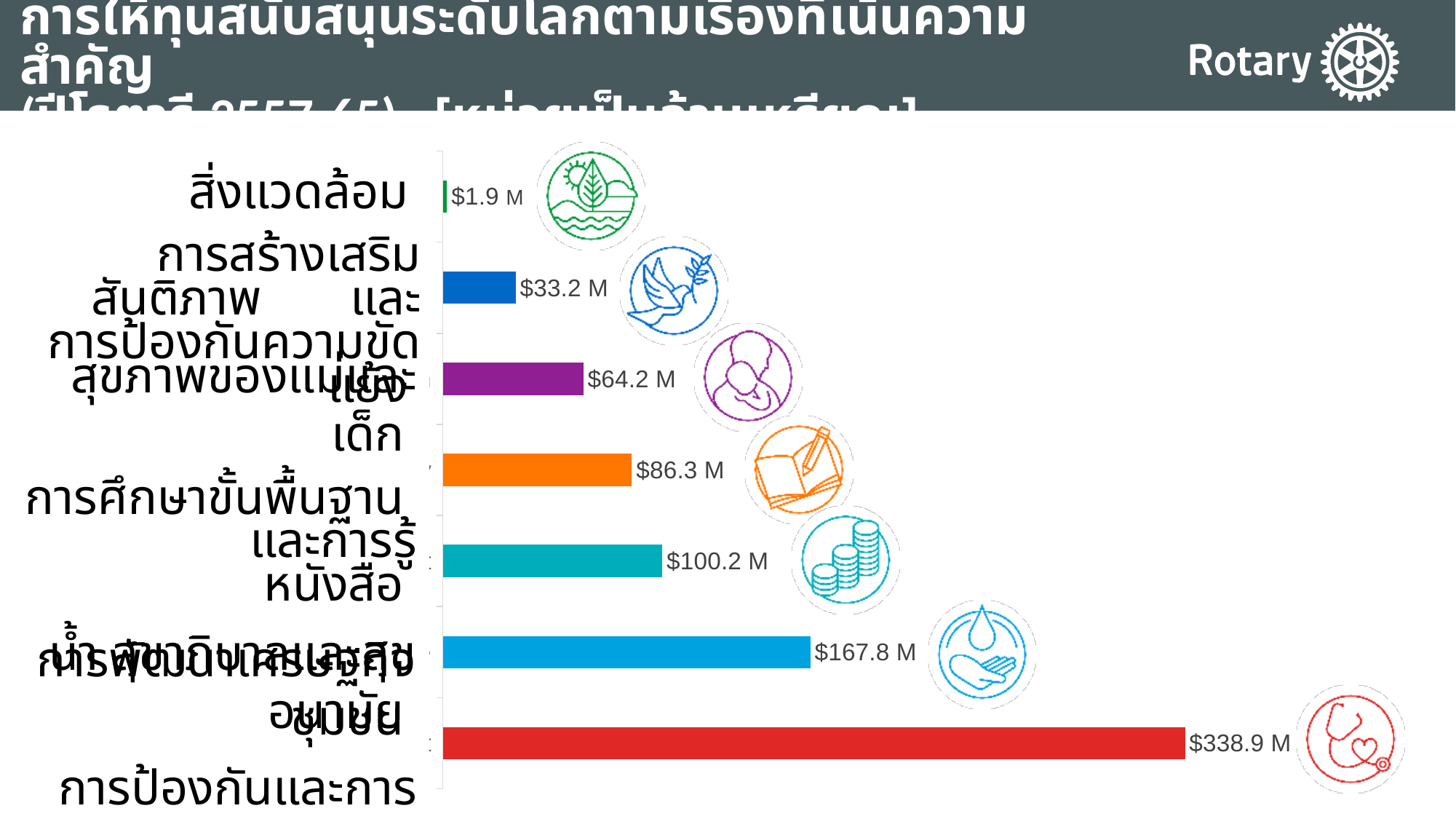
Which category has the lowest value in the chart? สิ่งแวดล้อม What is the value shown on the light blue bar with the water drop icon? $167.8 M What is the value shown on the orange bar (การศึกษาขั้นพื้นฐานและการรู้หนังสือ)? $86.3 M What is the difference between the teal bar ($100.2 M) and the orange bar ($86.3 M)? $13.9 M What is the value of the largest bar in the chart? $338.9 M What kind of chart is shown on the slide? bar chart What is the difference between the red bar ($338.9 M) and the light blue bar ($167.8 M)? $171.1 M What is the value shown on the purple bar (สุขภาพของแม่และเด็ก)? $64.2 M Which is larger: the dark blue bar with the dove icon or the purple bar with the mother-and-child icon? the purple bar ($64.2 M) What is the value shown for สิ่งแวดล้อม? $1.9 M How many bars are plotted in the chart? 7 What is the value shown on the red bar at the bottom of the chart? $338.9 M